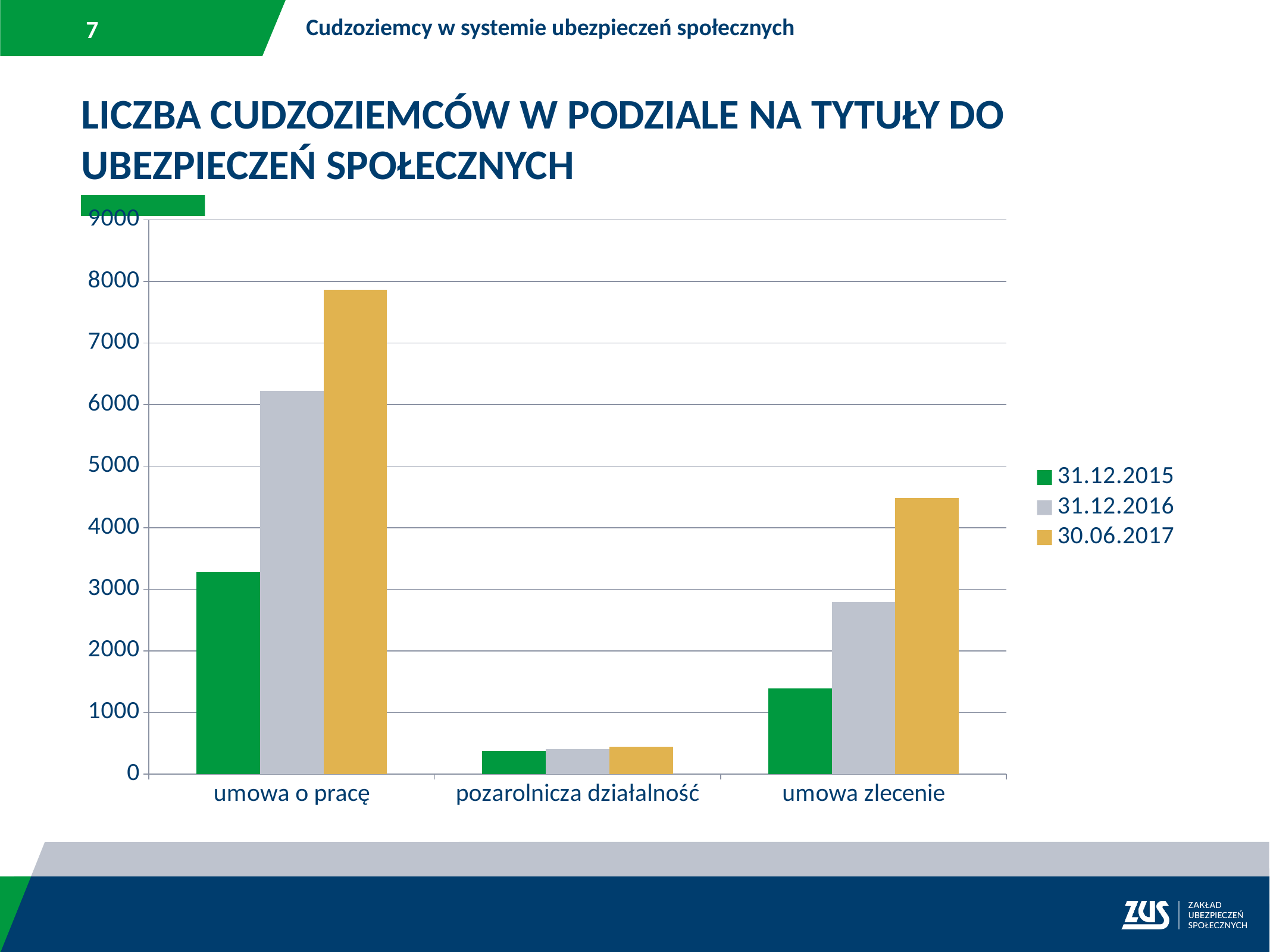
What are the three legend entries of the chart? 31.12.2015, 31.12.2016, 30.06.2017 Is the value for umowa zlecenie on 31.12.2016 greater or less than 3000? less How many categories are shown on the x axis? 3 Which category has the highest value for 30.06.2017? umowa o pracę How many series does the legend list? 3 Which category has the lowest value for 31.12.2015? pozarolnicza działalność Is the value for umowa o pracę on 31.12.2015 greater or less than 3000? greater Is the value for pozarolnicza działalność on 30.06.2017 greater or less than 1000? less For umowa zlecenie, do the values rise or fall from 31.12.2015 to 30.06.2017? rise What kind of chart is shown on the slide? bar chart Which is larger: umowa o pracę on 31.12.2016 or umowa zlecenie on 30.06.2017? umowa o pracę on 31.12.2016